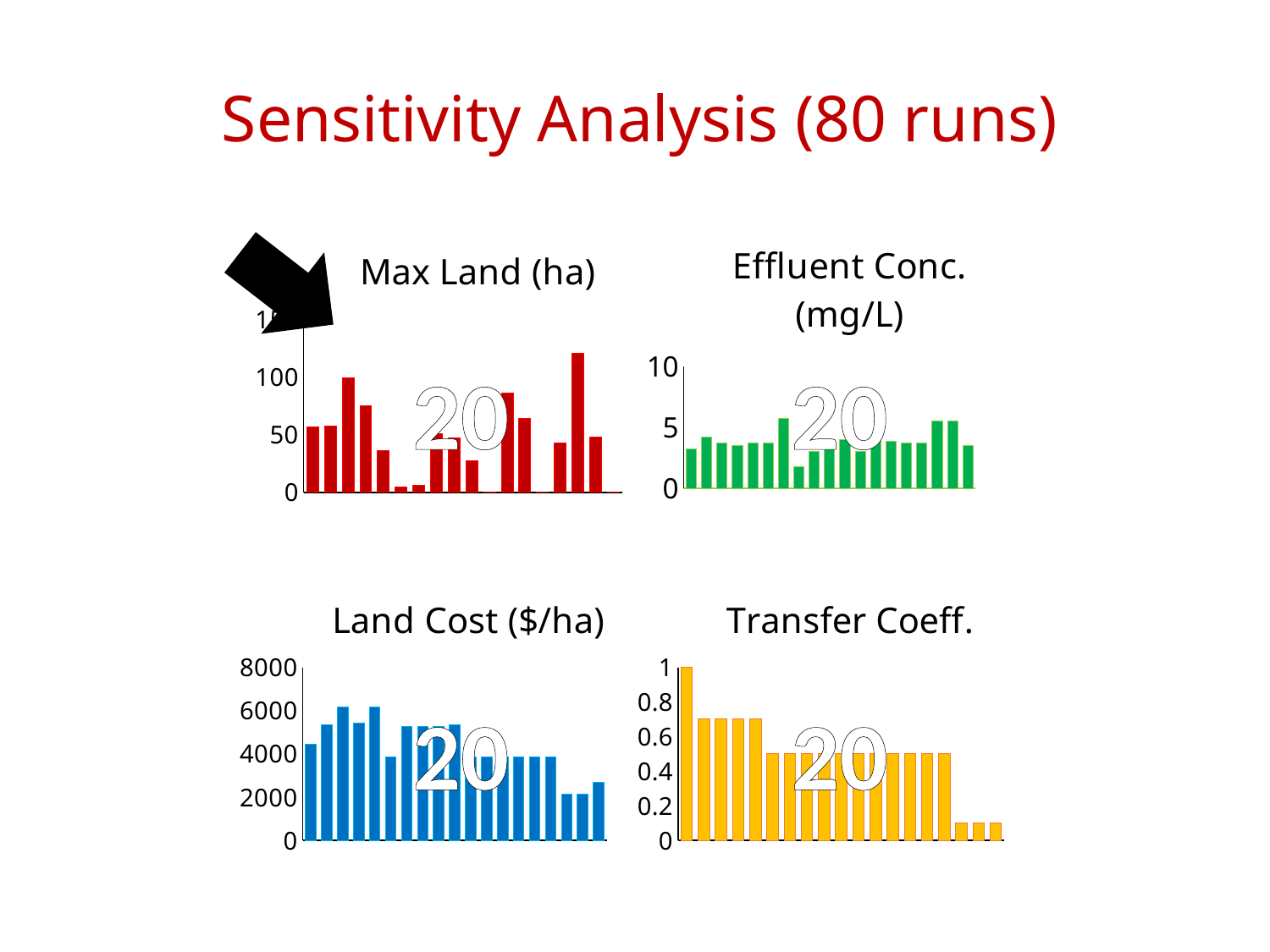
In the Effluent Conc. (mg/L) chart, is the value of the tallest bar greater or less than 5? greater In the Land Cost ($/ha) chart, is the value of the last (rightmost) bar greater or less than 4000? less What kind of chart is the Max Land (ha) chart? bar chart In the Transfer Coeff. chart, is the first bar or the last bar larger? the first bar How many bars does the Transfer Coeff. chart contain? 19 What is the title of the chart in the top-right position of the slide? Effluent Conc. (mg/L) What colour are the bars in the Land Cost ($/ha) chart? blue In the Land Cost ($/ha) chart, is the value of the first (leftmost) bar greater or less than 4000? greater How many bars does the Effluent Conc. (mg/L) chart contain? 19 In the Transfer Coeff. chart, do the values generally rise or fall from left to right? fall In the Transfer Coeff. chart, what is the value of the first (leftmost) bar? 1